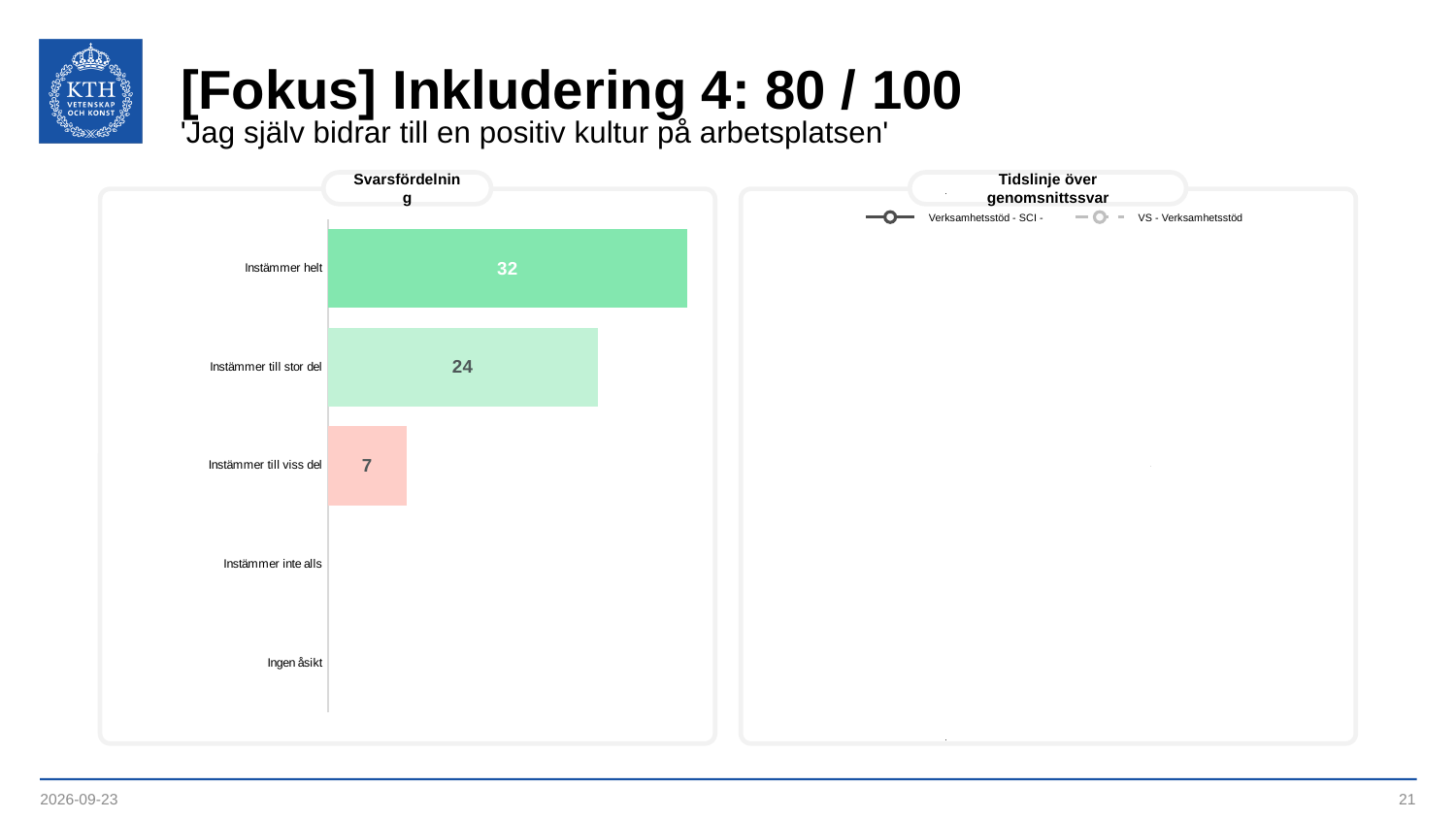
What kind of chart is the 'Svarsfördelning' chart? Bar chart How many categories are listed on the axis of the 'Svarsfördelning' chart? 5 In the 'Svarsfördelning' chart, what is the value for 'Instämmer till viss del'? 7 How many series does the legend of the 'Tidslinje över genomsnittssvar' chart list? 2 In the 'Svarsfördelning' chart, what is the difference between 'Instämmer helt' and 'Instämmer till stor del'? 8 In the 'Svarsfördelning' chart, what is the difference between 'Instämmer till stor del' and 'Instämmer till viss del'? 17 In the 'Svarsfördelning' chart, what is the value for 'Instämmer helt'? 32 What is the title of the chart on the right side of the slide? Tidslinje över genomsnittssvar In the 'Svarsfördelning' chart, which is larger: 'Instämmer till stor del' or 'Instämmer till viss del'? Instämmer till stor del In the 'Svarsfördelning' chart, what colour is the bar for 'Instämmer till viss del'? Light red / pink In the 'Svarsfördelning' chart, what is the value for 'Instämmer till stor del'? 24 In the 'Svarsfördelning' chart, which category has the highest value? Instämmer helt